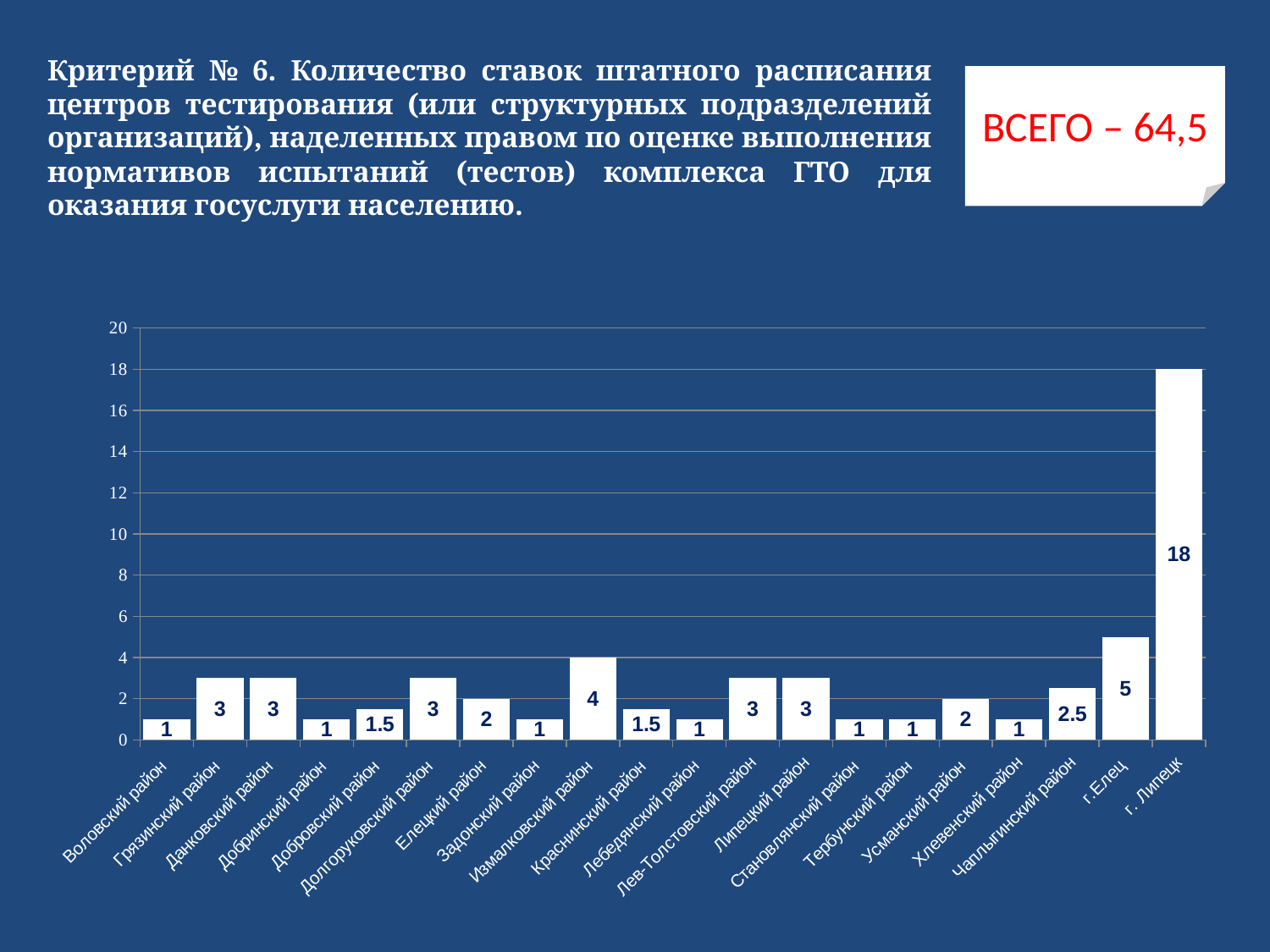
What is the value for Чаплыгинский район? 2.5 Which is larger, the value for Грязинский район or the value for Елецкий район? Грязинский район What kind of chart is shown on the slide? bar chart What is the difference between the values for Измалковский район and Усманский район? 2 Is the value for г. Липецк greater or less than 10? greater What is the value for Измалковский район? 4 What is the value for Добровский район? 1.5 Which category has the highest value? г. Липецк What is the value for г. Липецк? 18 What is the value for г.Елец? 5 What is the difference between the values for г. Липецк and г.Елец? 13 How many categories are shown on the x axis? 20